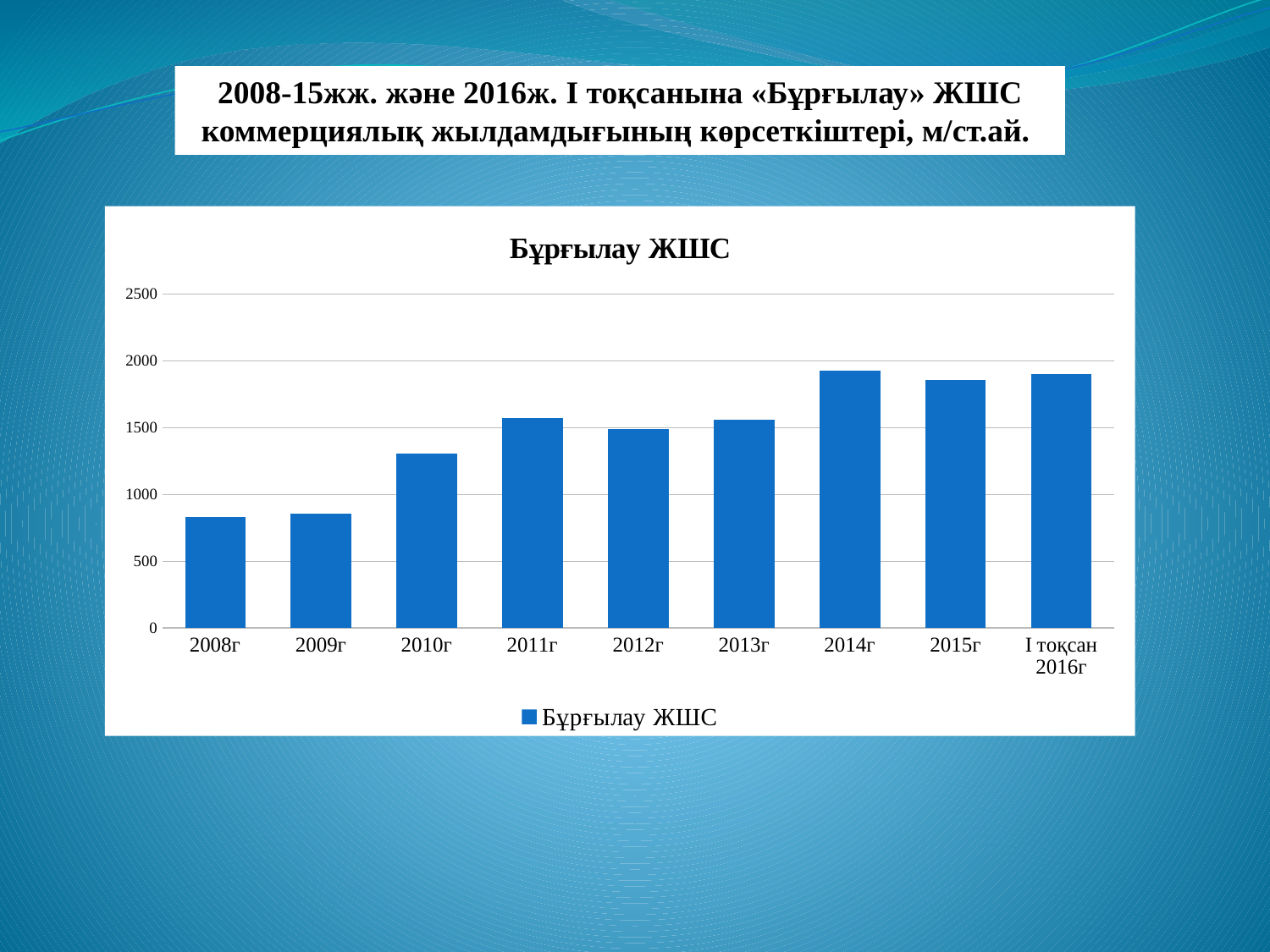
How many categories are shown on the x axis of the chart? 9 Is the value for 2014г greater or less than 2000? less What is the label of the last category on the x axis? I тоқсан 2016г Do the values generally rise or fall from 2008г to I тоқсан 2016г? rise How many series does the chart's legend list? 1 Which is larger, the value for 2014г or the value for 2012г? 2014г Which is larger, the value for 2010г or the value for 2008г? 2010г Is the value for 2010г greater or less than 1000? greater Is the value for 2008г greater or less than 1000? less What kind of chart is shown on the slide? bar chart What is the title of the chart? Бұрғылау ЖШС